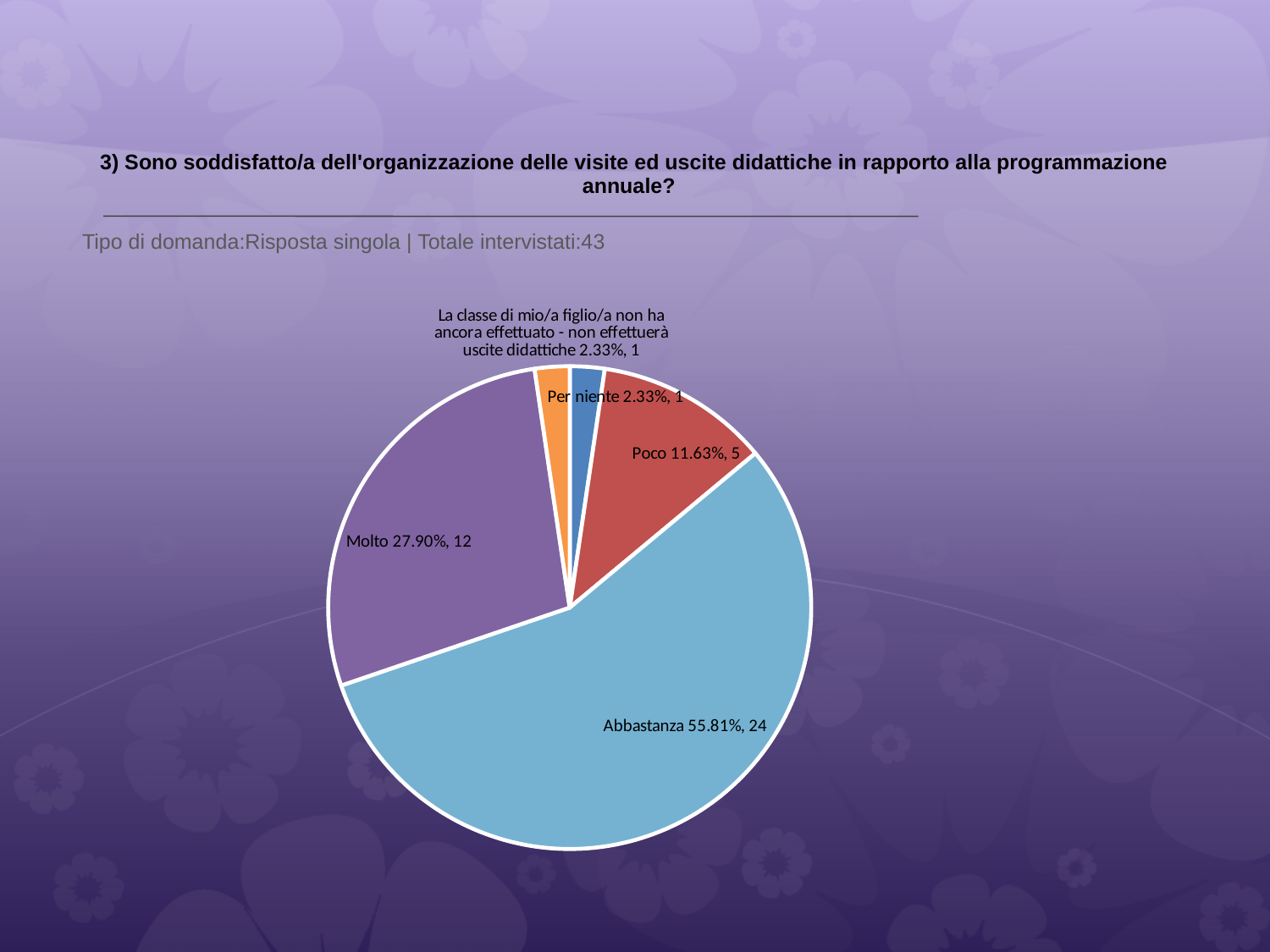
What percentage share does the "Molto" slice have? 27.90% What percentage share does the "Abbastanza" slice have? 55.81% How many slices does the pie chart have? 5 What kind of chart is shown on the slide? Pie chart What percentage share does the "Per niente" slice have? 2.33% How many respondents answered "Molto"? 12 What is the combined number of respondents for "Per niente" and "Poco"? 6 Which has more respondents, "Molto" or "Poco"? Molto How many respondents answered "Poco"? 5 What is the total number of respondents shown in the subtitle (Totale intervistati)? 43 What is the difference in number of respondents between "Abbastanza" and "Molto"? 12 Which category has the largest slice of the pie? Abbastanza